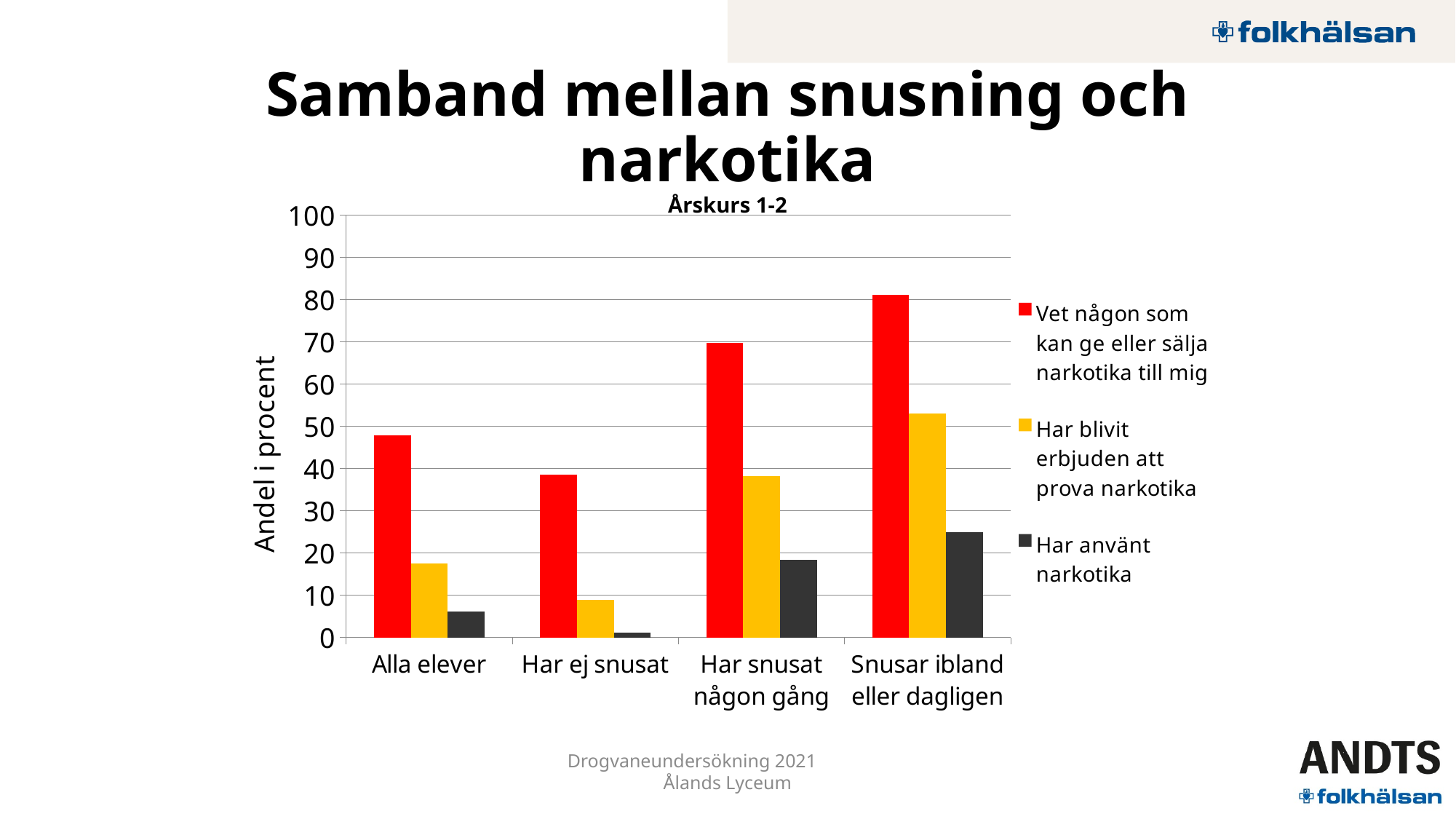
Does the value for 'Har använt narkotika' rise or fall from 'Har ej snusat' to 'Snusar ibland eller dagligen' along the x axis? rise Is the value for 'Vet någon som kan ge eller sälja narkotika till mig' in the 'Snusar ibland eller dagligen' category greater or less than 70? greater Is the value for 'Har använt narkotika' in the 'Alla elever' category greater or less than 10? less What is the label of the y axis? Andel i procent Which is larger: 'Har blivit erbjuden att prova narkotika' for 'Har snusat någon gång' or for 'Alla elever'? Har snusat någon gång How many series does the legend list? 3 Which category has the lowest value for 'Har använt narkotika'? Har ej snusat How many categories are shown on the x axis? 4 Is the value for 'Vet någon som kan ge eller sälja narkotika till mig' in the 'Har snusat någon gång' category greater or less than 60? greater What kind of chart is shown on the slide? bar chart Which category has the highest value for 'Vet någon som kan ge eller sälja narkotika till mig'? Snusar ibland eller dagligen